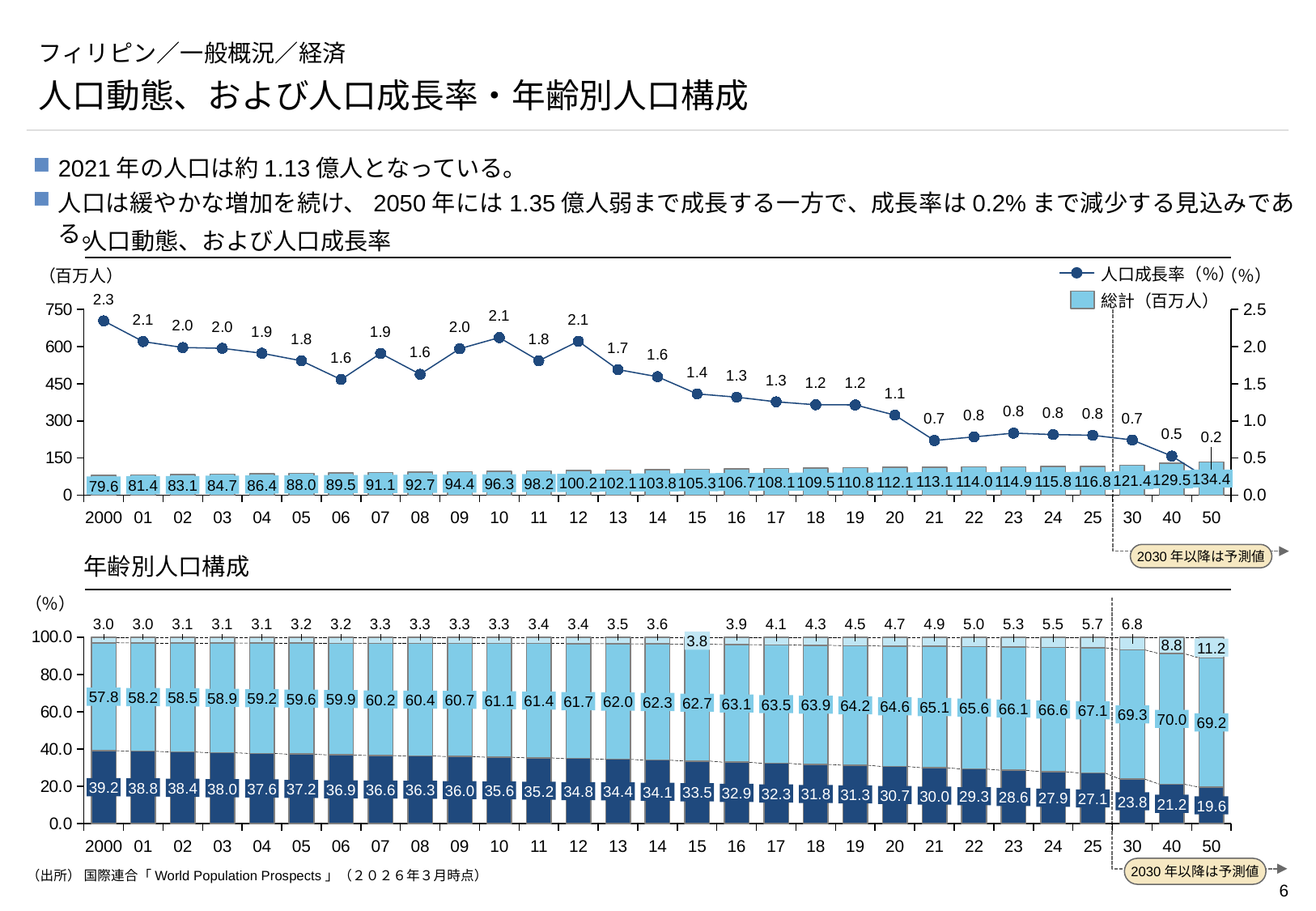
In the bottom chart (年齢別人口構成), what is the value of the dark blue bottom segment for 2000? 39.2 In the top chart (人口動態、および人口成長率), what is the difference between the 総計（百万人） values for 50 and 2000? 54.8 What kind of chart is the bottom chart (年齢別人口構成)? stacked bar chart In the top chart (人口動態、および人口成長率), what is the 人口成長率（%） value for 2000? 2.3 In the top chart (人口動態、および人口成長率), does the 人口成長率（%） line generally rise or fall from 2000 to 50? fall In the bottom chart (年齢別人口構成), what is the value of the top segment for 40? 8.8 In the bottom chart (年齢別人口構成), which is larger: the light blue middle segment for 50 or for 2000? 50 In the bottom chart (年齢別人口構成), does the dark blue bottom segment rise or fall from 2000 to 50? fall In the top chart (人口動態、および人口成長率), how many years are shown on the x axis? 29 In the top chart (人口動態、および人口成長率), what is the value of 総計（百万人） for 2021? 113.1 In the top chart (人口動態、および人口成長率), which year has the lowest 人口成長率（%） value? 50 In the top chart (人口動態、および人口成長率), how many series does the legend list? 2